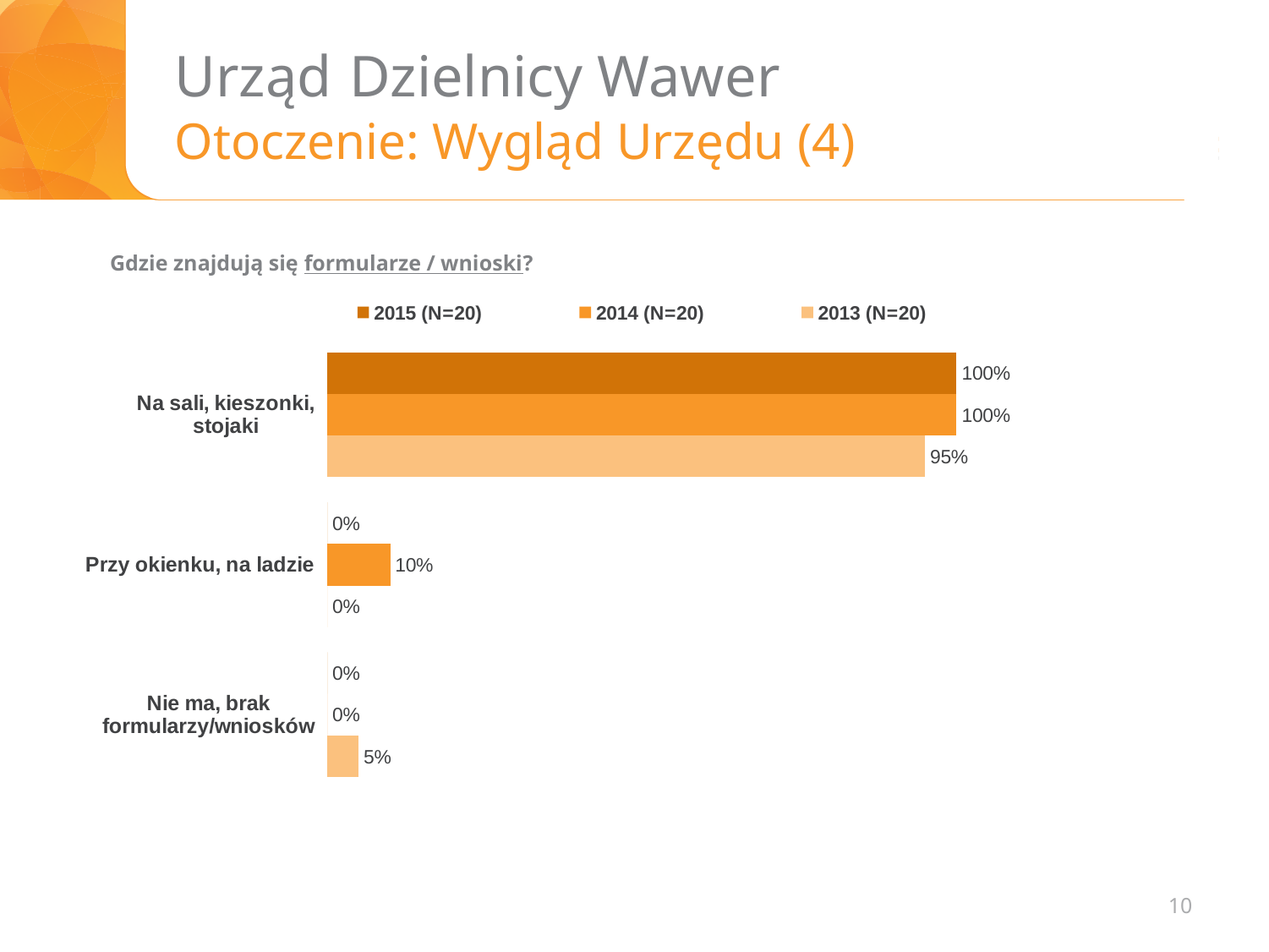
What is the value for "Na sali, kieszonki, stojaki" in the 2013 (N=20) series? 95% Which series is shown in the lightest orange colour? 2013 (N=20) Which is larger for "Przy okienku, na ladzie": the 2014 (N=20) value or the 2013 (N=20) value? 2014 (N=20) What is the value for "Nie ma, brak formularzy/wniosków" in the 2013 (N=20) series? 5% What is the value for "Na sali, kieszonki, stojaki" in the 2015 (N=20) series? 100% Which category has the highest value in the 2014 (N=20) series? Na sali, kieszonki, stojaki What is the value for "Przy okienku, na ladzie" in the 2014 (N=20) series? 10% What question does the chart answer, as stated above it? Gdzie znajdują się formularze / wnioski? What is the difference between the 2015 (N=20) and 2013 (N=20) values for "Na sali, kieszonki, stojaki"? 5% How many categories are shown on the chart? 3 What kind of chart is shown on the slide? Bar chart How many series does the legend list? 3